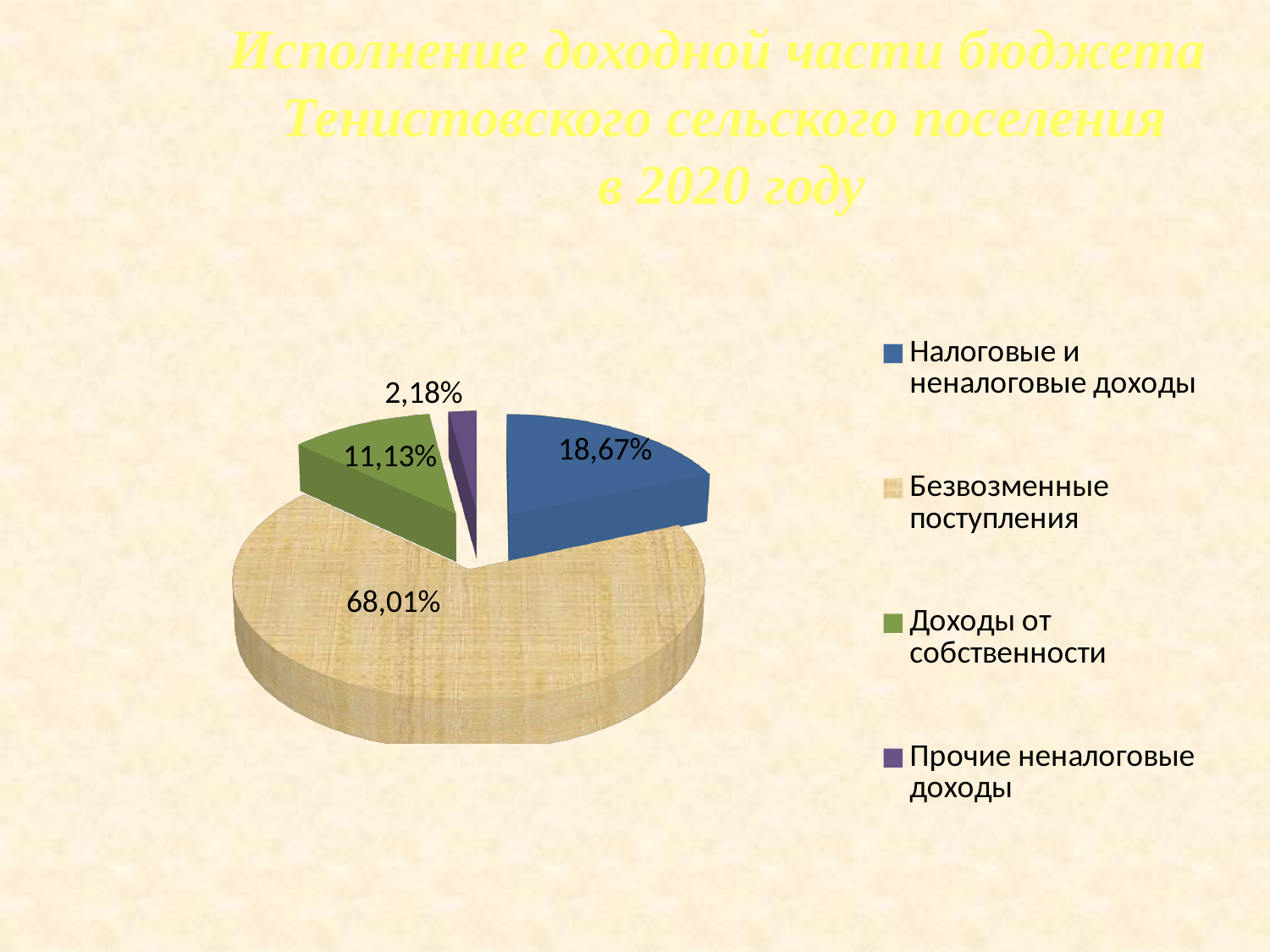
What colour is the slice for Налоговые и неналоговые доходы? Blue What share of the pie does Безвозмездные поступления have? 68,01% What is the value shown for Доходы от собственности? 11,13% What is the value shown for Прочие неналоговые доходы? 2,18% Which category has the largest slice of the pie? Безвозменные поступления How many categories are shown in the pie chart? 4 Which category has the smallest slice of the pie? Прочие неналоговые доходы Which is larger: Доходы от собственности or Прочие неналоговые доходы? Доходы от собственности What kind of chart is shown on the slide? Pie chart What is the value shown for Налоговые и неналоговые доходы? 18,67% What is the difference between the shares of Налоговые и неналоговые доходы and Доходы от собственности? 7,54% What year does the chart title refer to? 2020